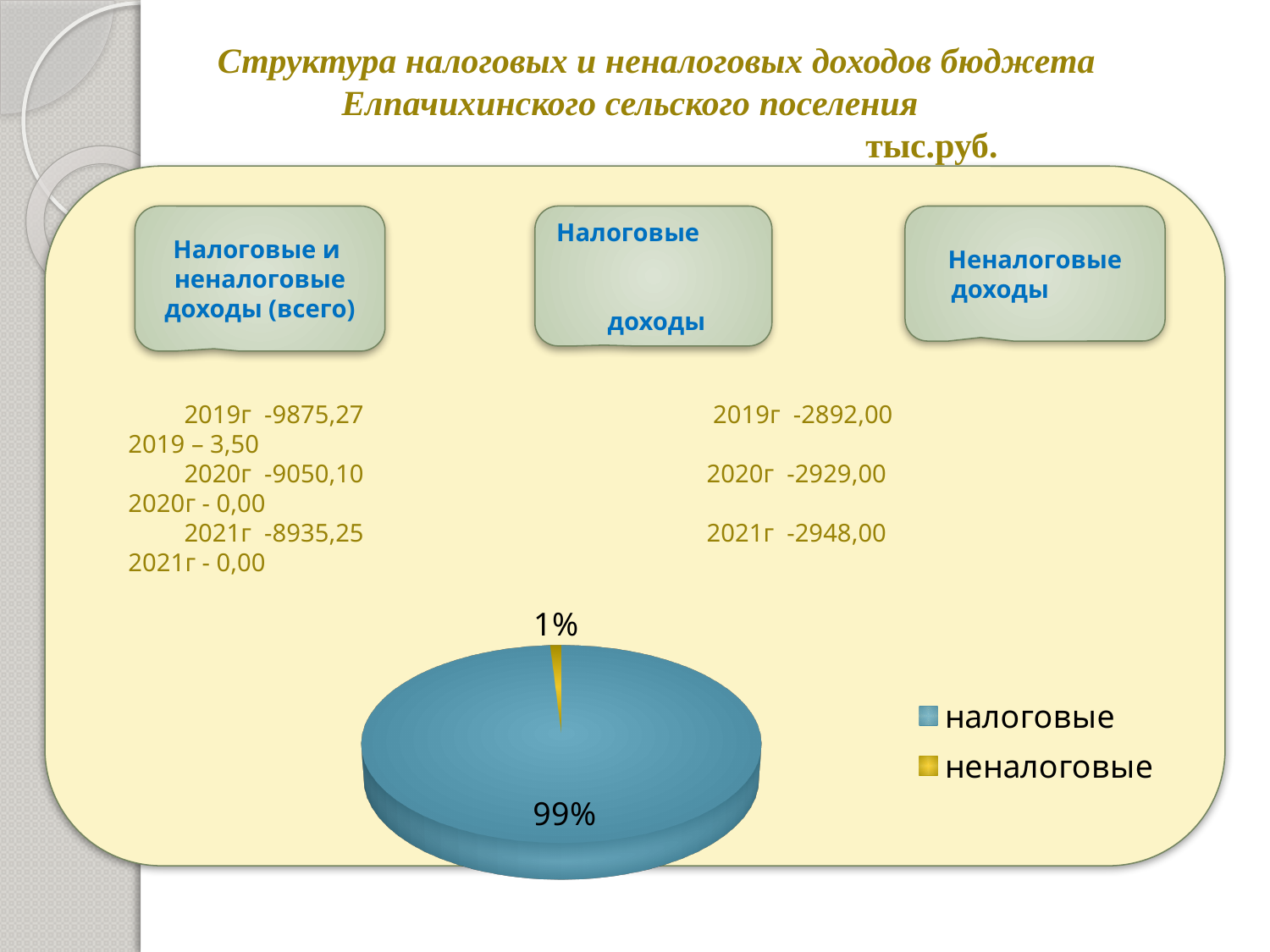
Which is larger in the pie chart, "налоговые" or "неналоговые"? налоговые What share of the pie chart does the "налоговые" slice take? 99% What kind of chart is shown on the slide? pie chart What share of the pie chart does the "неналоговые" slice take? 1% How many entries does the legend of the pie chart list? 2 What colour is the "неналоговые" slice in the pie chart? yellow How many slices does the pie chart have? 2 Which slice of the pie chart is the largest? налоговые By how many percentage points does the "налоговые" slice exceed the "неналоговые" slice in the pie chart? 98 What colour is the "налоговые" slice in the pie chart? blue What is the data label shown on the "неналоговые" slice of the pie chart? 1% Which slice of the pie chart is the smallest? неналоговые